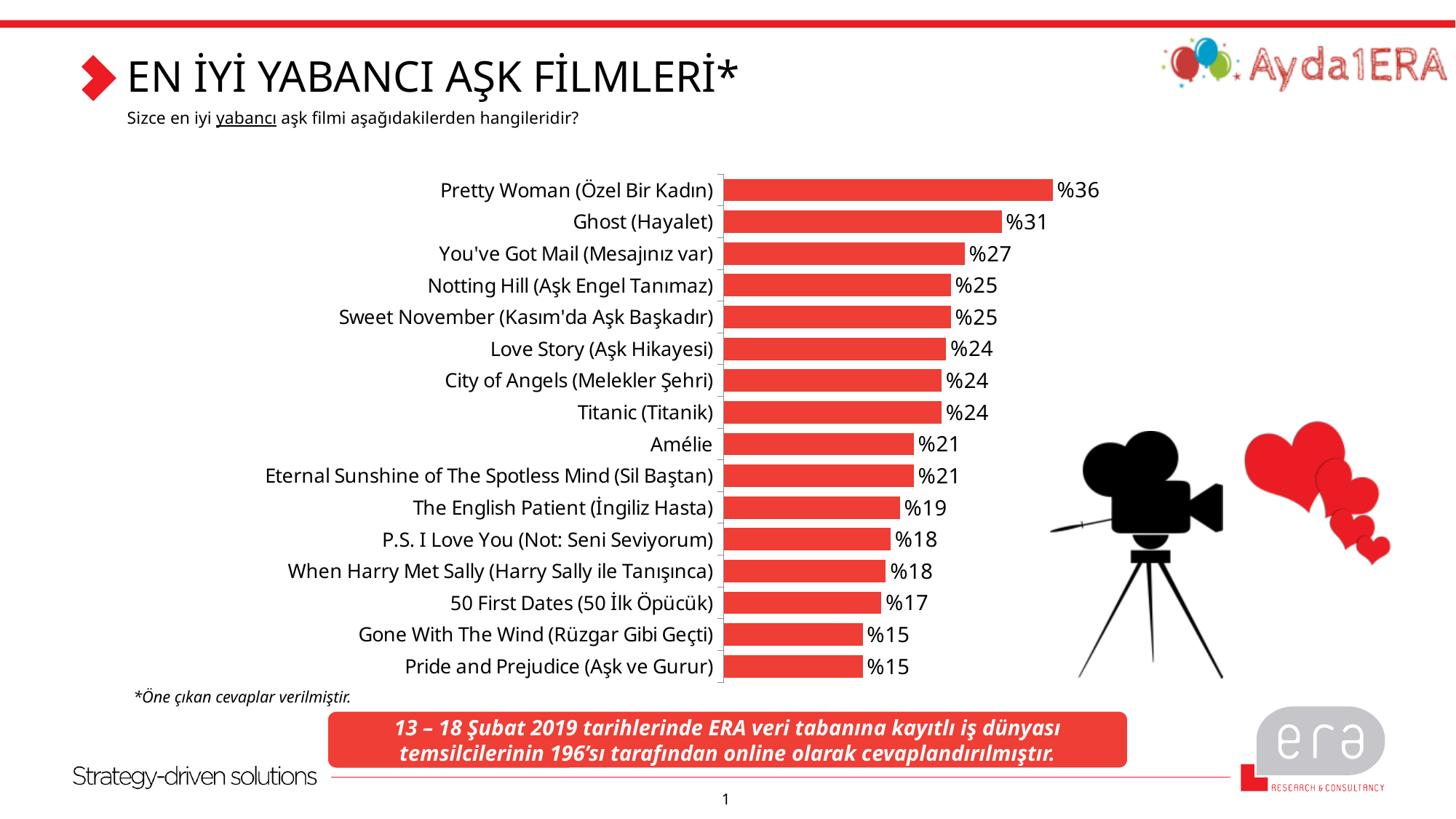
How many films are shown in the chart? 16 What is the difference between the values for Pretty Woman (Özel Bir Kadın) and Ghost (Hayalet)? 5 percentage points Which has a larger value, Notting Hill (Aşk Engel Tanımaz) or P.S. I Love You (Not: Seni Seviyorum)? Notting Hill (Aşk Engel Tanımaz) What is the difference between the values for You've Got Mail (Mesajınız var) and The English Patient (İngiliz Hasta)? 8 percentage points What is the value for Amélie? %21 Which has a larger value, Titanic (Titanik) or Gone With The Wind (Rüzgar Gibi Geçti)? Titanic (Titanik) What kind of chart is shown on the slide? Bar chart What is the value for Pretty Woman (Özel Bir Kadın)? %36 What is the value for Ghost (Hayalet)? %31 Which film has the highest value? Pretty Woman (Özel Bir Kadın) What colour are the bars in the chart? Red What is the value for 50 First Dates (50 İlk Öpücük)? %17